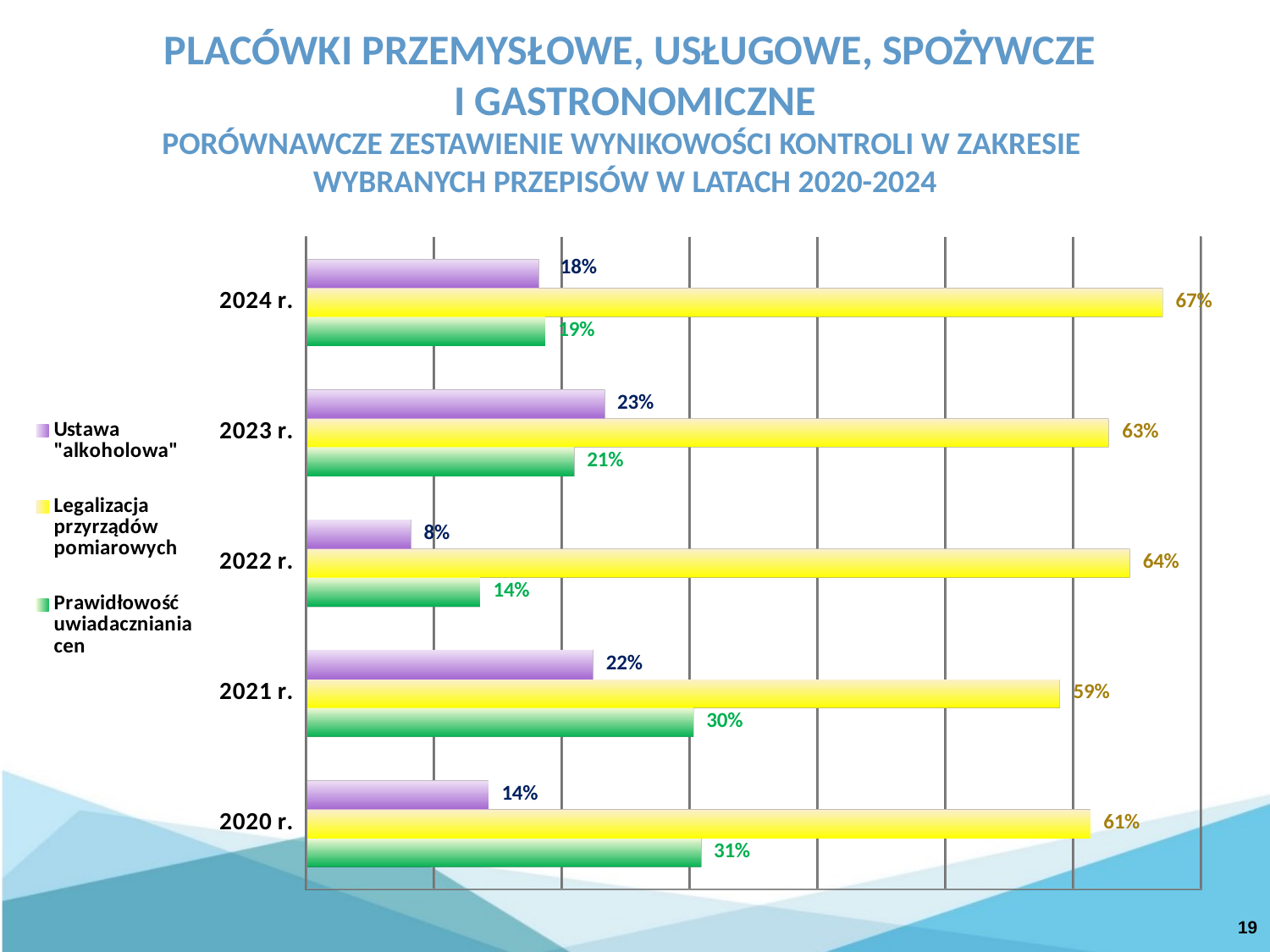
Which colour represents Legalizacja przyrządów pomiarowych in the chart? Yellow What is the value for Prawidłowość uwiadaczniania cen in 2020 r.? 31% What is the value for Ustawa "alkoholowa" in 2022 r.? 8% What is the value for Legalizacja przyrządów pomiarowych in 2024 r.? 67% What is the value for Prawidłowość uwiadaczniania cen in 2021 r.? 30% How many years are shown on the chart? 5 What kind of chart is shown on the slide? Bar chart What is the difference between the Legalizacja przyrządów pomiarowych values for 2024 r. and 2021 r.? 8% In which year is the value for Legalizacja przyrządów pomiarowych the highest? 2024 r. Which is larger in 2023 r.: the value for Ustawa "alkoholowa" or the value for Prawidłowość uwiadaczniania cen? Ustawa "alkoholowa" How many series does the legend list? 3 In which year is the value for Ustawa "alkoholowa" the lowest? 2022 r.